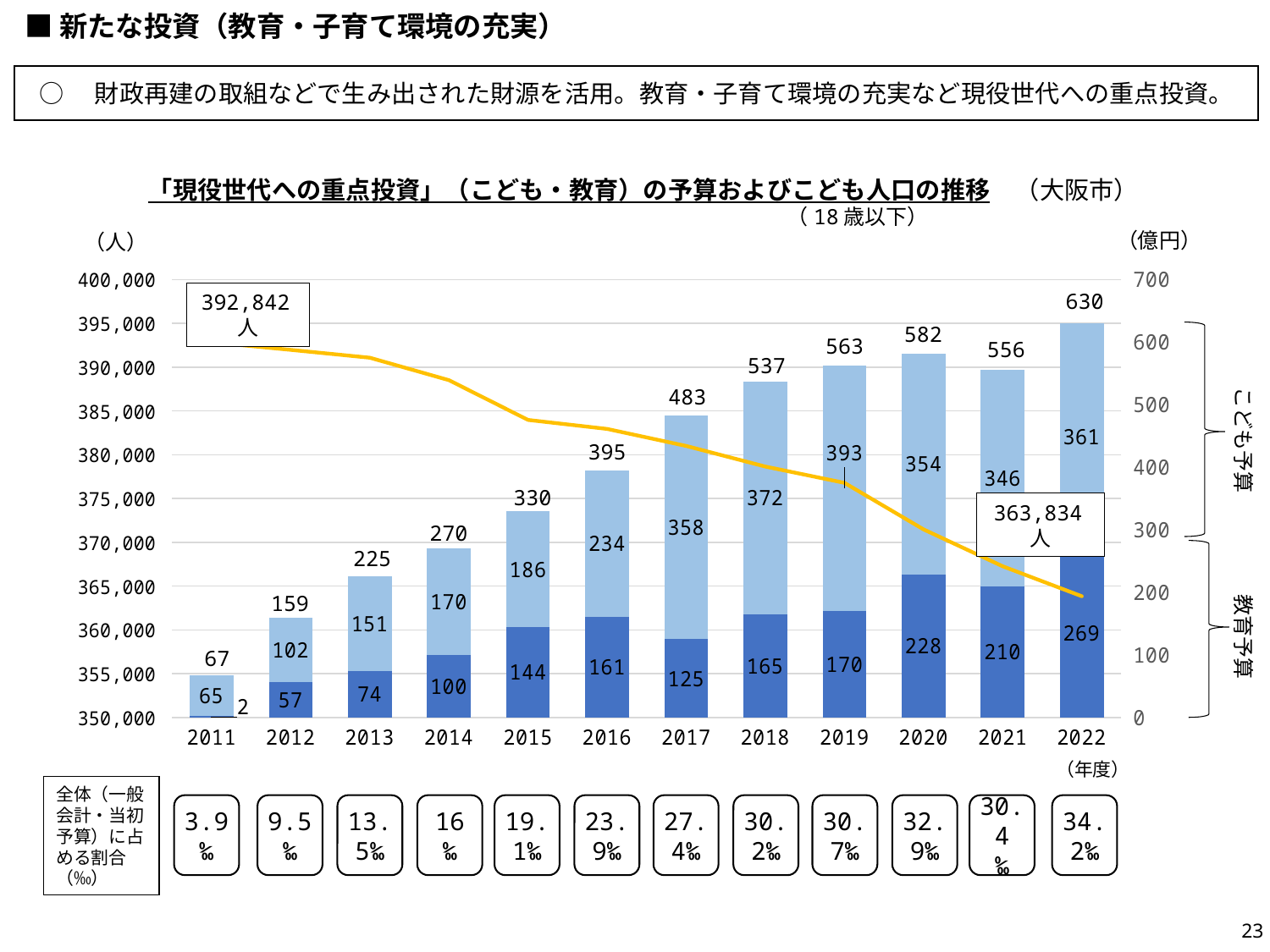
Is the こども予算 segment larger in 2018 or in 2020? 2018 Which year has the lowest total budget bar? 2011 What is the こども予算 (light blue segment) value for 2019? 393 What is the difference between the total budget in 2020 and in 2021? 26 What is the total budget (億円) shown above the stacked bar for 2022? 630 What is the 教育予算 (dark blue segment) value for 2020? 228 Is the child population in 2016 greater or less than 380,000? greater What is the child population (人) labelled on the line for 2011? 392,842人 Which year has the highest total budget bar? 2022 How many fiscal years are shown on the x axis? 12 Does the child population line rise or fall from 2011 to 2022? fall What is the child population (人) labelled on the line for 2022? 363,834人